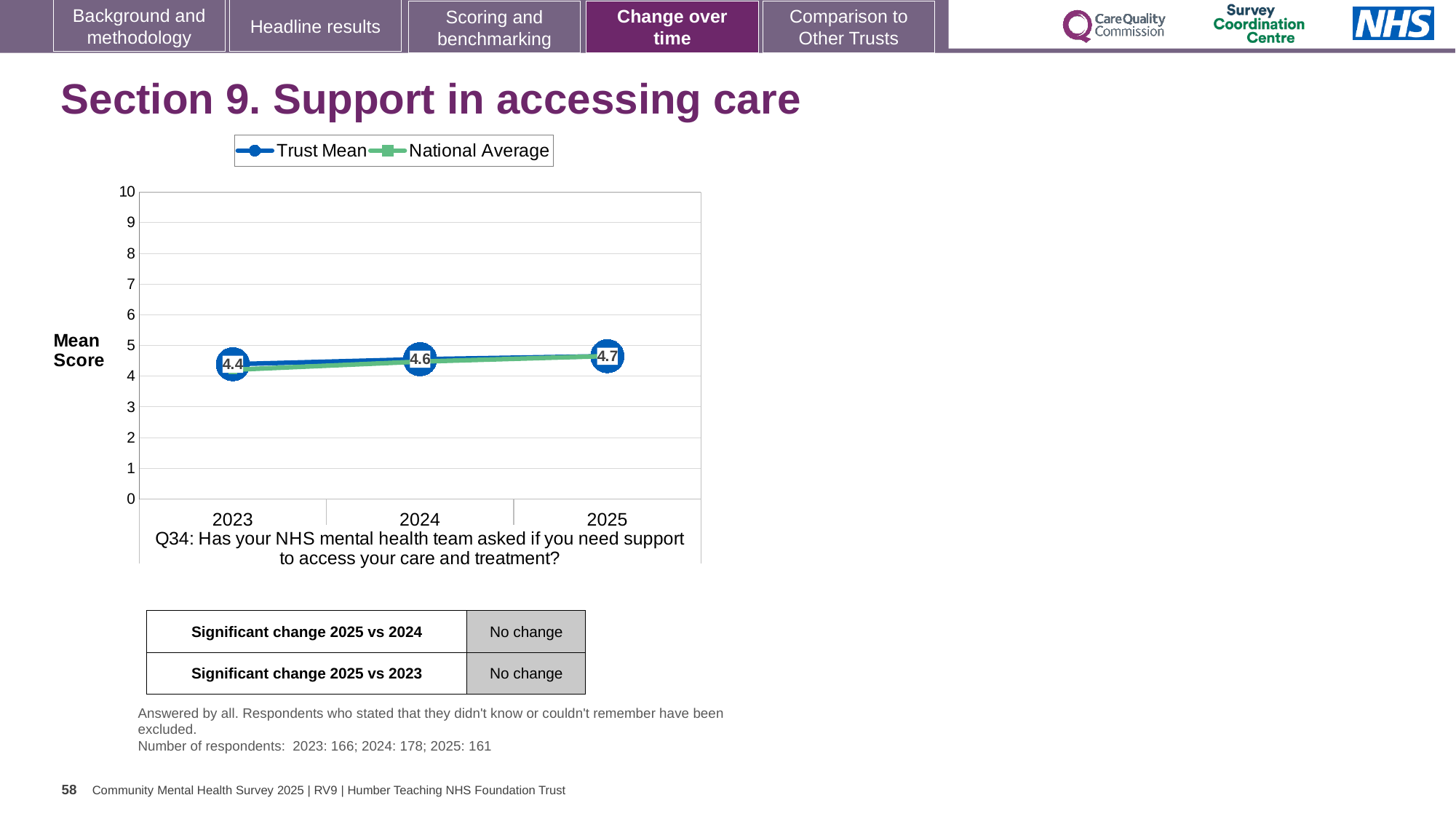
Does the Trust Mean score rise or fall from 2023 to 2025? Rise How many series does the legend list? 2 What is the Trust Mean score for 2023? 4.4 Is the National Average value for 2023 greater or less than 5? less By how much did the Trust Mean score change from 2023 to 2025? 0.3 Which is larger, the Trust Mean score for 2024 or for 2025? 2025 In which year is the Trust Mean score highest? 2025 How many years are plotted on the x axis? 3 What is the Trust Mean score for 2025? 4.7 What is the Trust Mean score for 2024? 4.6 What kind of chart is shown on the slide? Line chart In which year is the Trust Mean score lowest? 2023